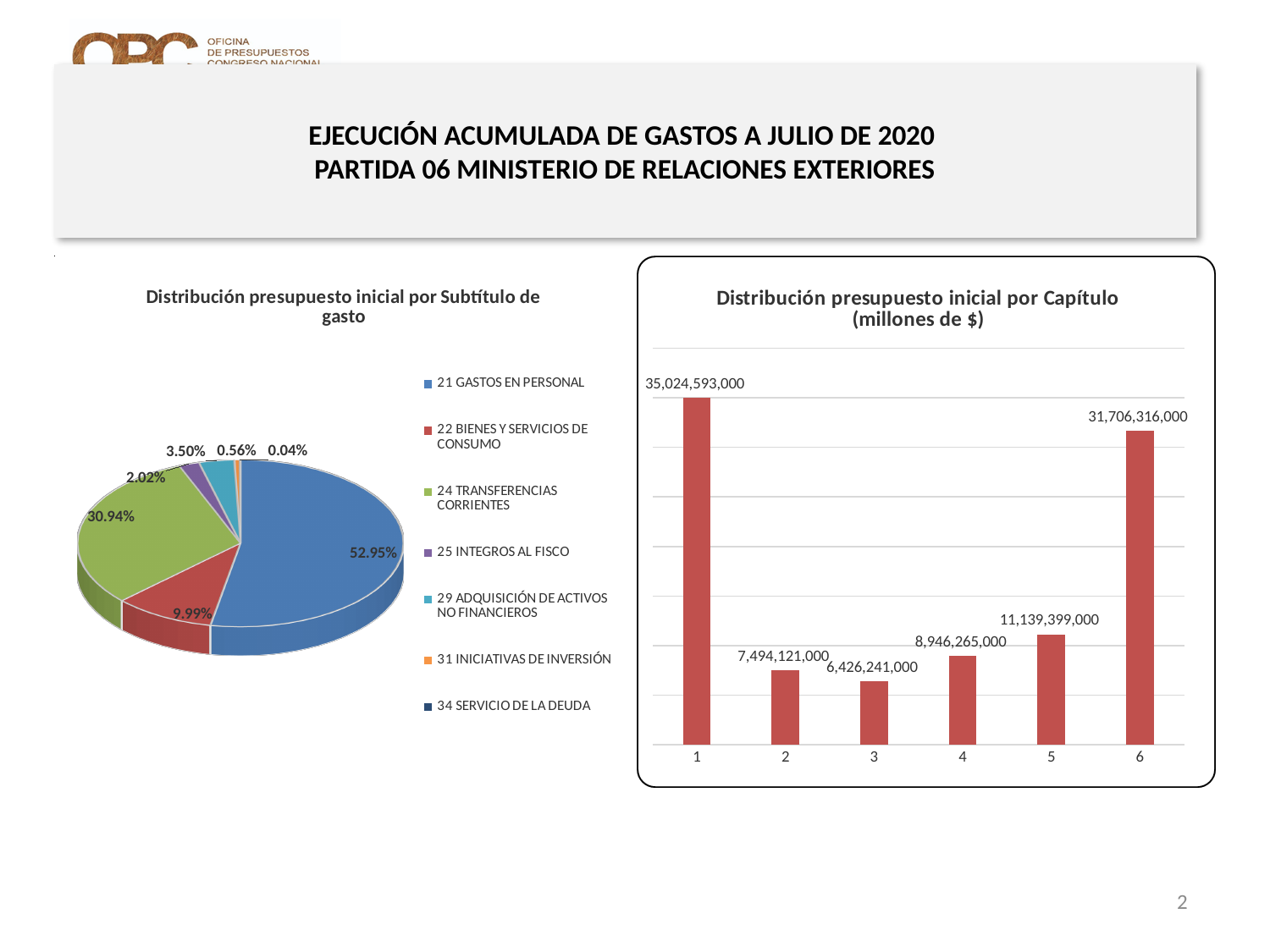
In the bar chart 'Distribución presupuesto inicial por Capítulo (millones de $)', which is larger, the value for category 2 or category 4? Category 4 How many categories are shown in the bar chart 'Distribución presupuesto inicial por Capítulo (millones de $)'? 6 In the bar chart 'Distribución presupuesto inicial por Capítulo (millones de $)', what is the value for category 5? 11,139,399,000 In the pie chart 'Distribución presupuesto inicial por Subtítulo de gasto', which category has the smallest share? 34 SERVICIO DE LA DEUDA How many entries does the legend of the pie chart 'Distribución presupuesto inicial por Subtítulo de gasto' list? 7 What kind of chart is 'Distribución presupuesto inicial por Capítulo (millones de $)'? Bar chart In the bar chart 'Distribución presupuesto inicial por Capítulo (millones de $)', what is the difference between the values for category 1 and category 6? 3,318,277,000 In the pie chart 'Distribución presupuesto inicial por Subtítulo de gasto', what share does 24 TRANSFERENCIAS CORRIENTES have? 30.94% In the bar chart 'Distribución presupuesto inicial por Capítulo (millones de $)', which category has the highest value? 1 In the bar chart 'Distribución presupuesto inicial por Capítulo (millones de $)', which category has the lowest value? 3 In the pie chart 'Distribución presupuesto inicial por Subtítulo de gasto', what share does 21 GASTOS EN PERSONAL have? 52.95% In the bar chart 'Distribución presupuesto inicial por Capítulo (millones de $)', what is the value for category 1? 35,024,593,000